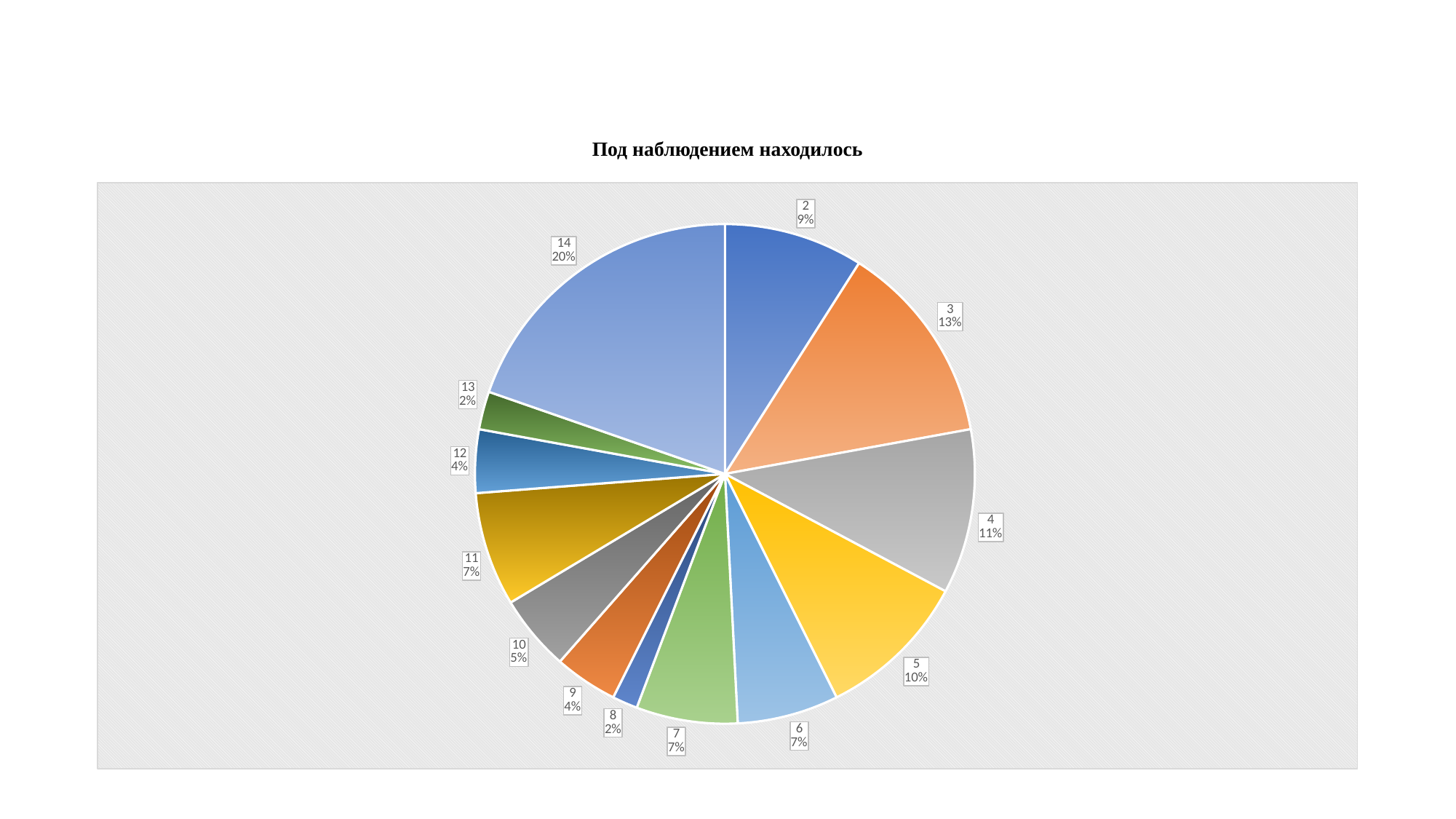
What is the difference in percentage points between slice 14 and slice 3? 7 What percentage is shown for slice 9? 4% What is the difference in percentage points between slice 2 and slice 8? 7 What percentage is shown for slice 3? 13% Which slice has the largest share of the pie? 14 What percentage is shown for slice 10? 5% What percentage is shown for slice 14? 20% Which slice is larger, slice 4 or slice 5? 4 What is the title of the chart? Под наблюдением находилось Which slice is larger, slice 11 or slice 12? 11 What kind of chart is shown on the slide? pie chart How many slices does the pie chart have? 13